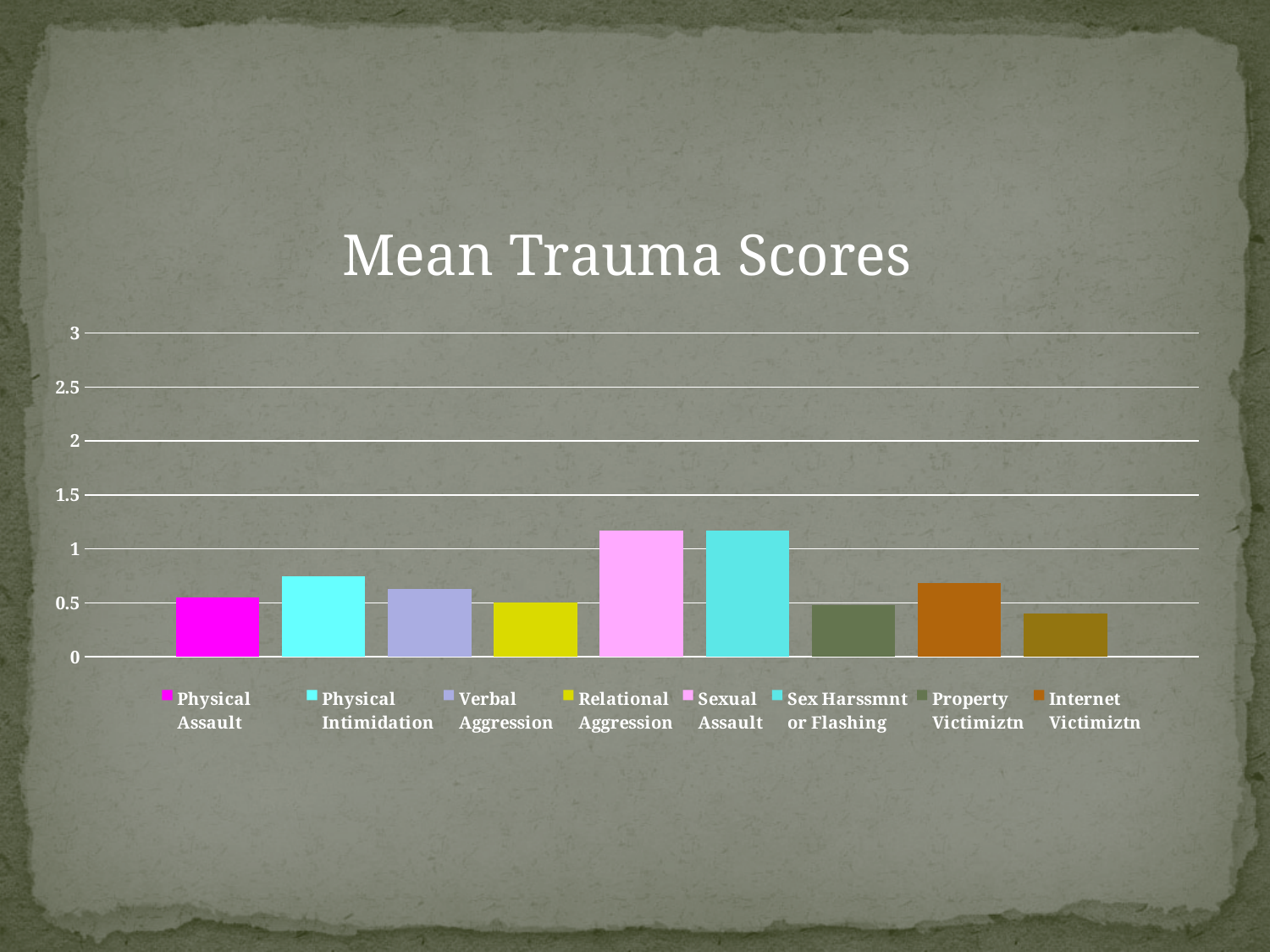
What is the title of the chart? Mean Trauma Scores Is the value for Sexual Assault greater or less than 1? greater Is the value for Physical Intimidation greater or less than 0.5? greater Is the value for Sex Harssmnt or Flashing greater or less than 1.5? less Which has the higher mean trauma score, Sexual Assault or Physical Assault? Sexual Assault How many entries does the legend of the Mean Trauma Scores chart list? 8 Which has the higher mean trauma score, Physical Intimidation or Internet Victimiztn? Physical Intimidation What kind of chart is shown on the slide? bar chart What colour is the bar for Physical Assault? magenta How many bars are plotted in the Mean Trauma Scores chart? 9